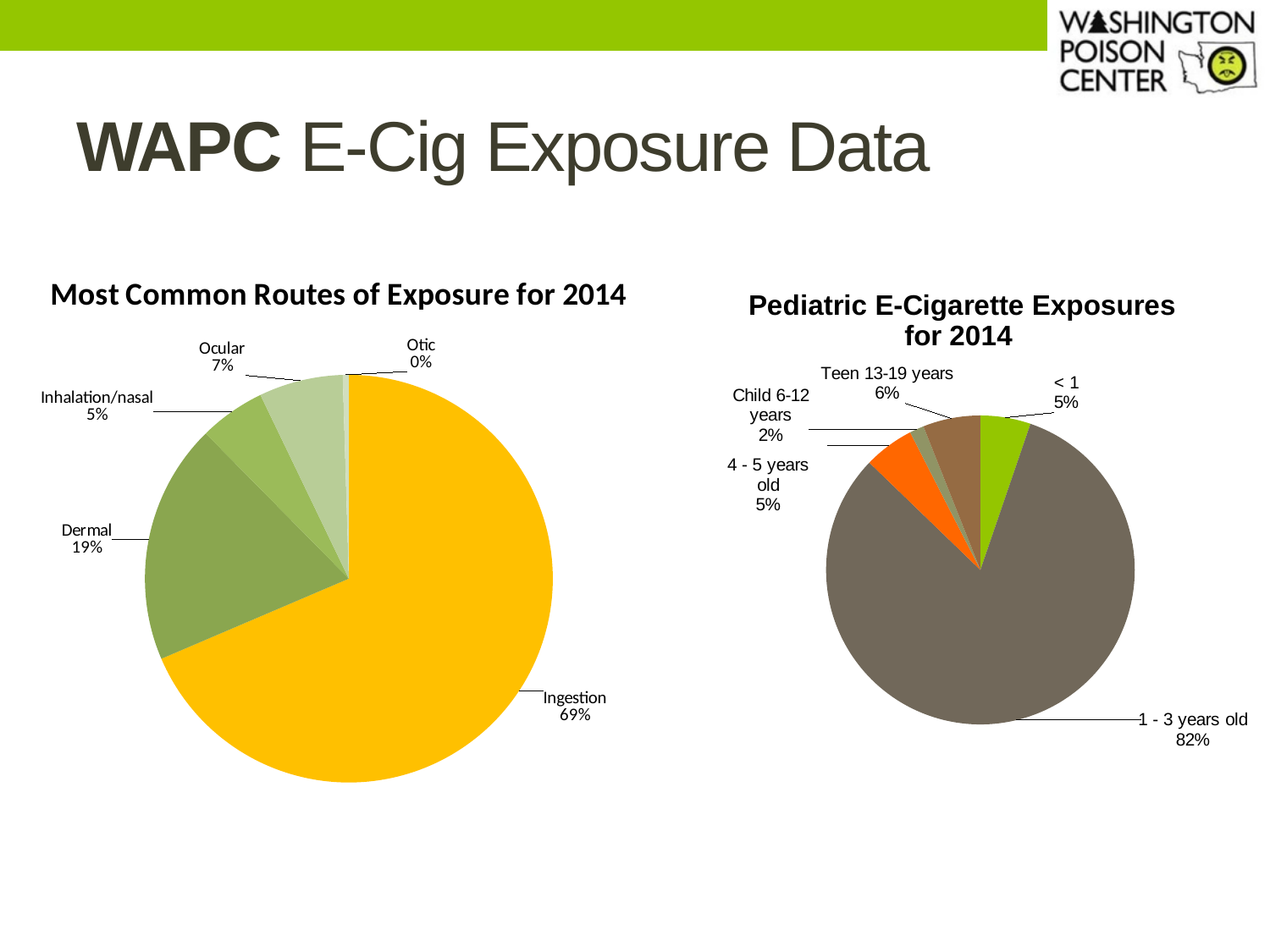
In the 'Pediatric E-Cigarette Exposures for 2014' chart, which age group has the largest share? 1 - 3 years old In the 'Most Common Routes of Exposure for 2014' chart, which route has the smallest share? Otic In the 'Pediatric E-Cigarette Exposures for 2014' chart, what is the value for Teen 13-19 years? 6% In the 'Most Common Routes of Exposure for 2014' chart, which is larger, Ocular or Inhalation/nasal? Ocular In the 'Most Common Routes of Exposure for 2014' chart, what share does Ingestion have? 69% In the 'Most Common Routes of Exposure for 2014' chart, how many routes of exposure are shown? 5 In the 'Pediatric E-Cigarette Exposures for 2014' chart, how many age groups are shown? 5 What kind of chart is 'Pediatric E-Cigarette Exposures for 2014'? Pie chart In the 'Most Common Routes of Exposure for 2014' chart, what is the value for Dermal? 19% In the 'Pediatric E-Cigarette Exposures for 2014' chart, which age group has the smallest share? Child 6-12 years In the 'Most Common Routes of Exposure for 2014' chart, what is the difference between Dermal and Ocular? 12% In the 'Pediatric E-Cigarette Exposures for 2014' chart, what is the difference between 1 - 3 years old and Teen 13-19 years? 76%